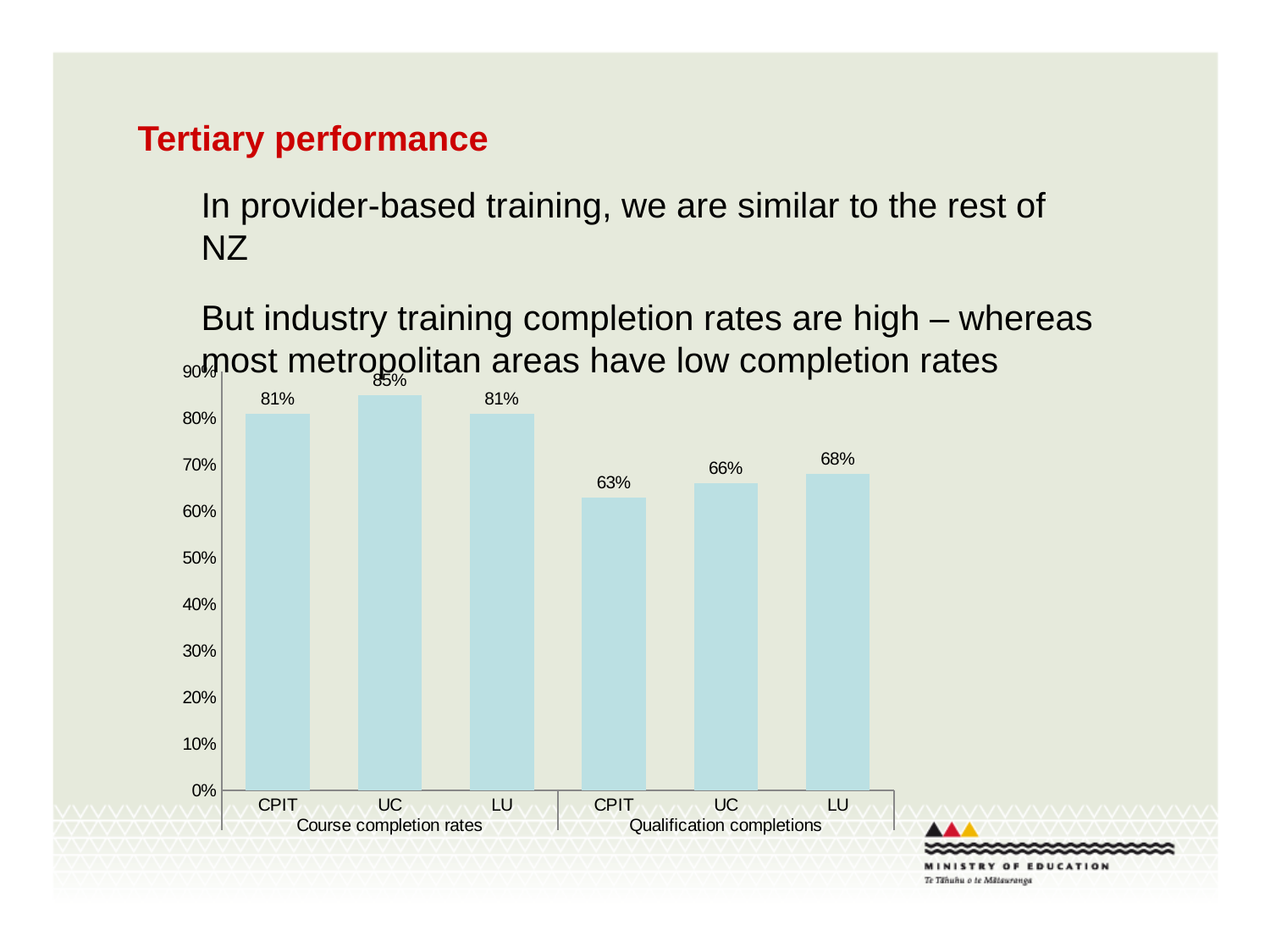
What is the difference between the course completion rate and the qualification completion rate for UC? 19% Which bar has the lowest value on the chart? CPIT qualification completions (63%) What is the difference between the qualification completion rates of LU and CPIT? 5% Which is larger: the qualification completion rate for UC or for LU? LU Which bar has the highest value on the chart? UC course completion rates (85%) How many bars are plotted on the chart? 6 What is the qualification completion rate for CPIT? 63% What is the course completion rate for UC? 85% What is the course completion rate for CPIT? 81% What is the qualification completion rate for LU? 68% What are the two groups of categories shown on the x axis? Course completion rates and Qualification completions What kind of chart is shown on the slide? Bar chart